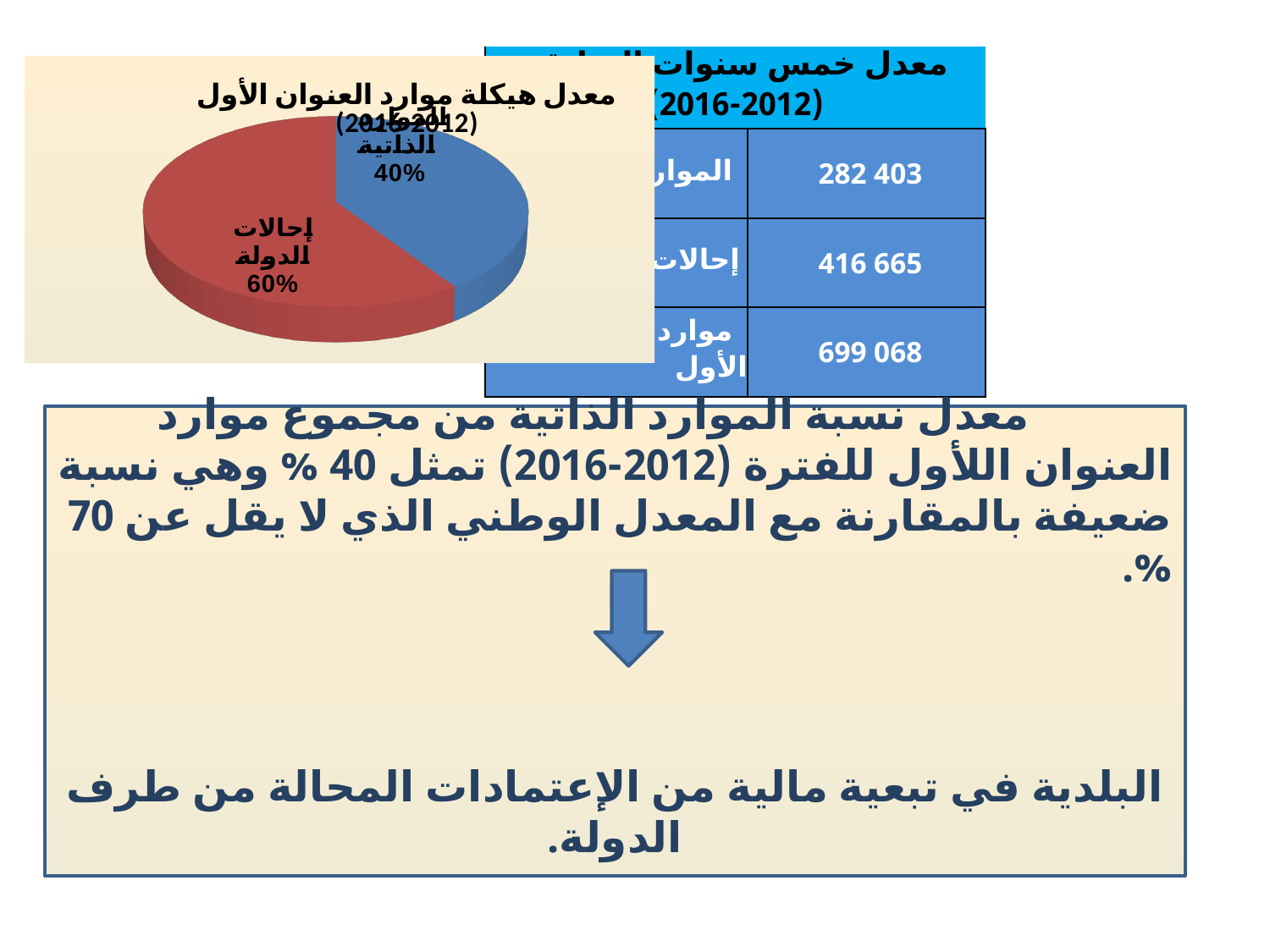
Which slice of the pie chart is the smallest? الموارد الذاتية Which is larger in the pie chart, الموارد الذاتية or إحالات الدولة? إحالات الدولة What share of the pie does الموارد الذاتية represent? 40% Is the share for الموارد الذاتية greater or less than 50%? less What share of the pie does إحالات الدولة represent? 60% What colour is the الموارد الذاتية slice in the pie chart? Blue What colour is the إحالات الدولة slice in the pie chart? Red Which slice of the pie chart is the largest? إحالات الدولة What kind of chart is shown on the slide? Pie chart How many slices does the pie chart have? 2 What is the difference in percentage points between the إحالات الدولة slice and the الموارد الذاتية slice? 20